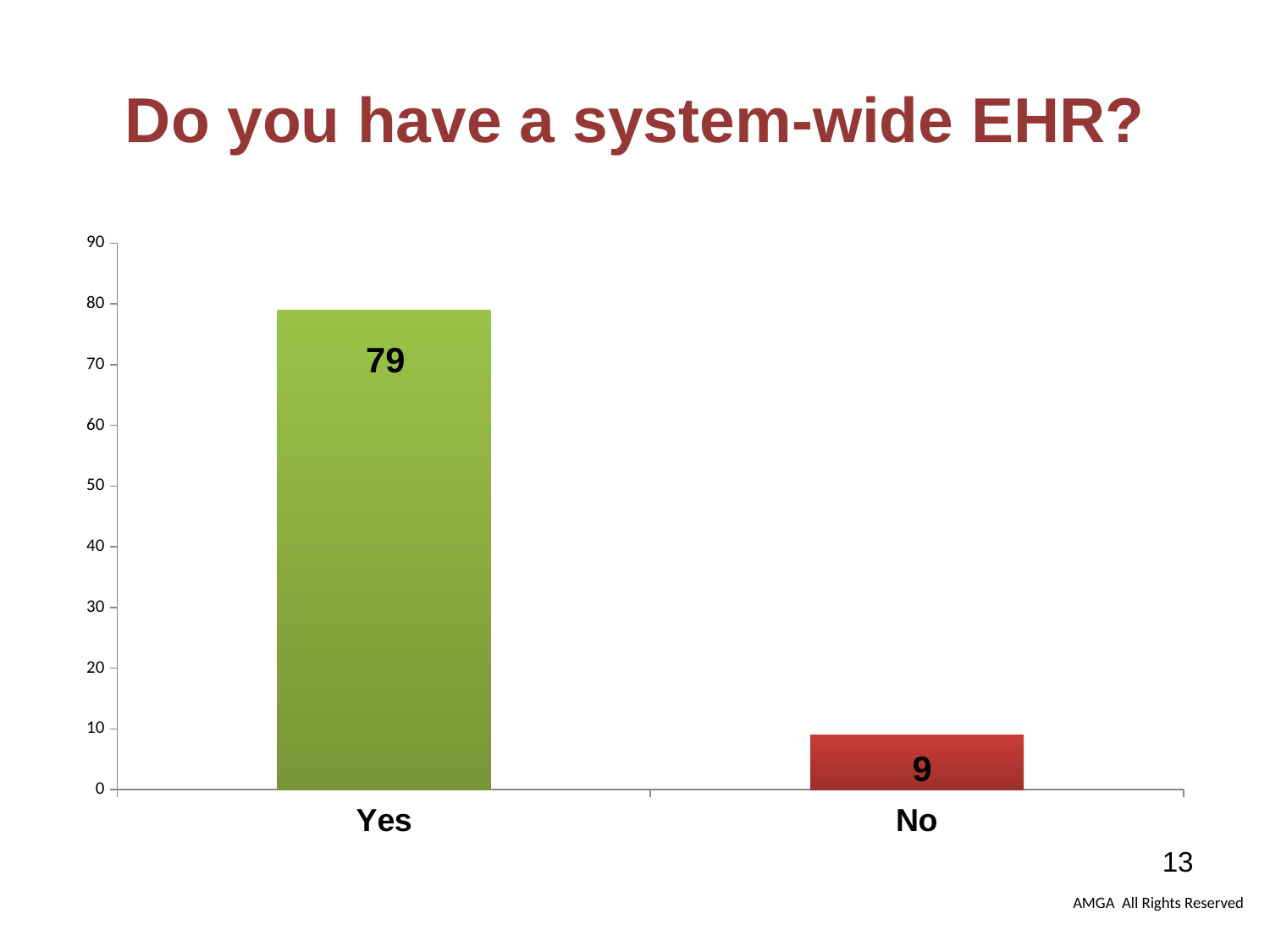
What is the title of the slide? Do you have a system-wide EHR? What is the difference between the values for Yes and No? 70 What is the value for No? 9 Which category has the highest value? Yes What kind of chart is shown on the slide? bar chart What colour is the bar for No? red How many categories are shown on the x axis? 2 Is the value for No greater or less than 20? less What is the value for Yes? 79 Is the value for Yes greater or less than 70? greater Which is larger, the value for Yes or the value for No? Yes Which category has the lowest value? No